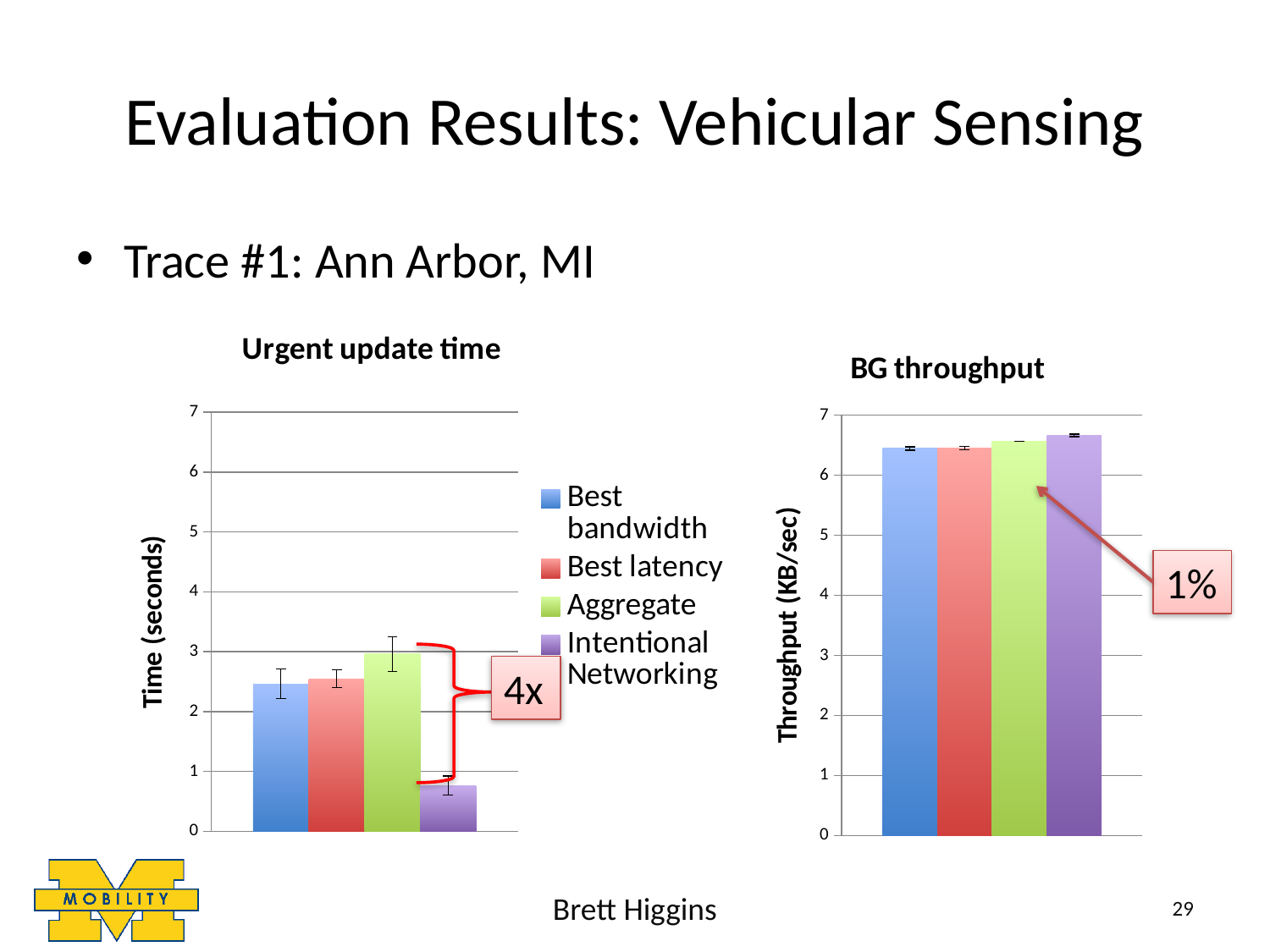
In the "BG throughput" chart, is the value for Intentional Networking greater or less than 5? greater What is the y-axis title of the "BG throughput" chart? Throughput (KB/sec) How many bars are plotted in the "BG throughput" chart? 4 How many series does the legend list for the "Urgent update time" chart? 4 In the "Urgent update time" chart, which is larger, the value for Best latency or the value for Intentional Networking? Best latency What kind of chart is the "Urgent update time" chart? bar chart In the "Urgent update time" chart, which series has the lowest value? Intentional Networking In the "Urgent update time" chart, which series has the highest value? Aggregate In the "BG throughput" chart, is the value for Best bandwidth greater or less than 6? greater In the "Urgent update time" chart, is the value for Intentional Networking greater or less than 1? less What factor is shown in the annotation next to the "Urgent update time" chart? 4x